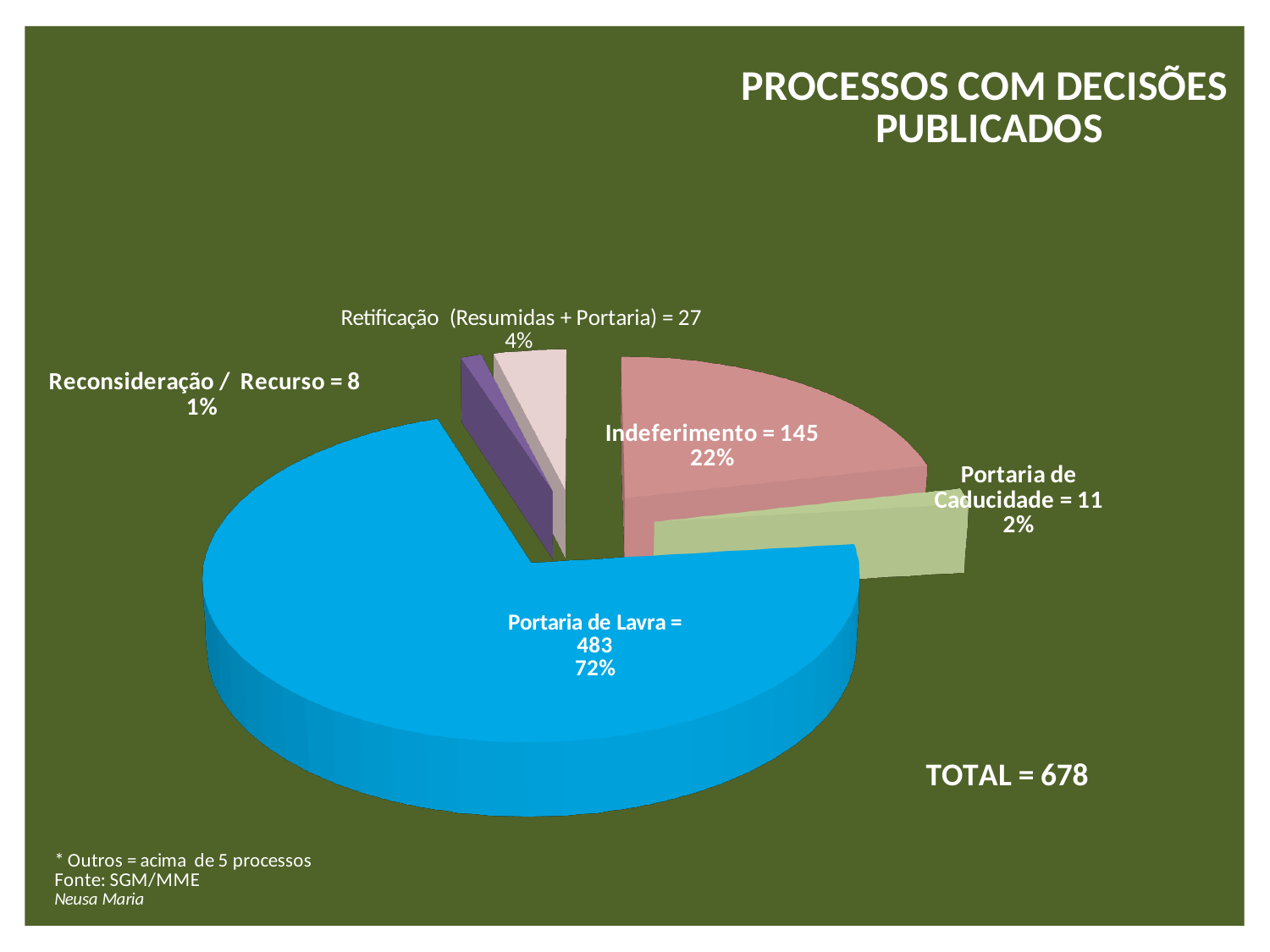
What is the value for Indeferimento? 145 What is the value for Portaria de Caducidade? 11 What is the difference between the values for Portaria de Lavra and Indeferimento? 338 What is the value for Portaria de Lavra? 483 How many categories does the pie chart show? 5 Which category has the smallest slice of the pie? Reconsideração / Recurso What is the value for Retificação (Resumidas + Portaria)? 27 Which category has the largest slice of the pie? Portaria de Lavra What kind of chart is shown on the slide? pie chart What share of the pie does Reconsideração / Recurso represent? 1% Which is larger, the value for Retificação (Resumidas + Portaria) or the value for Portaria de Caducidade? Retificação (Resumidas + Portaria) What share of the pie does Indeferimento represent? 22%